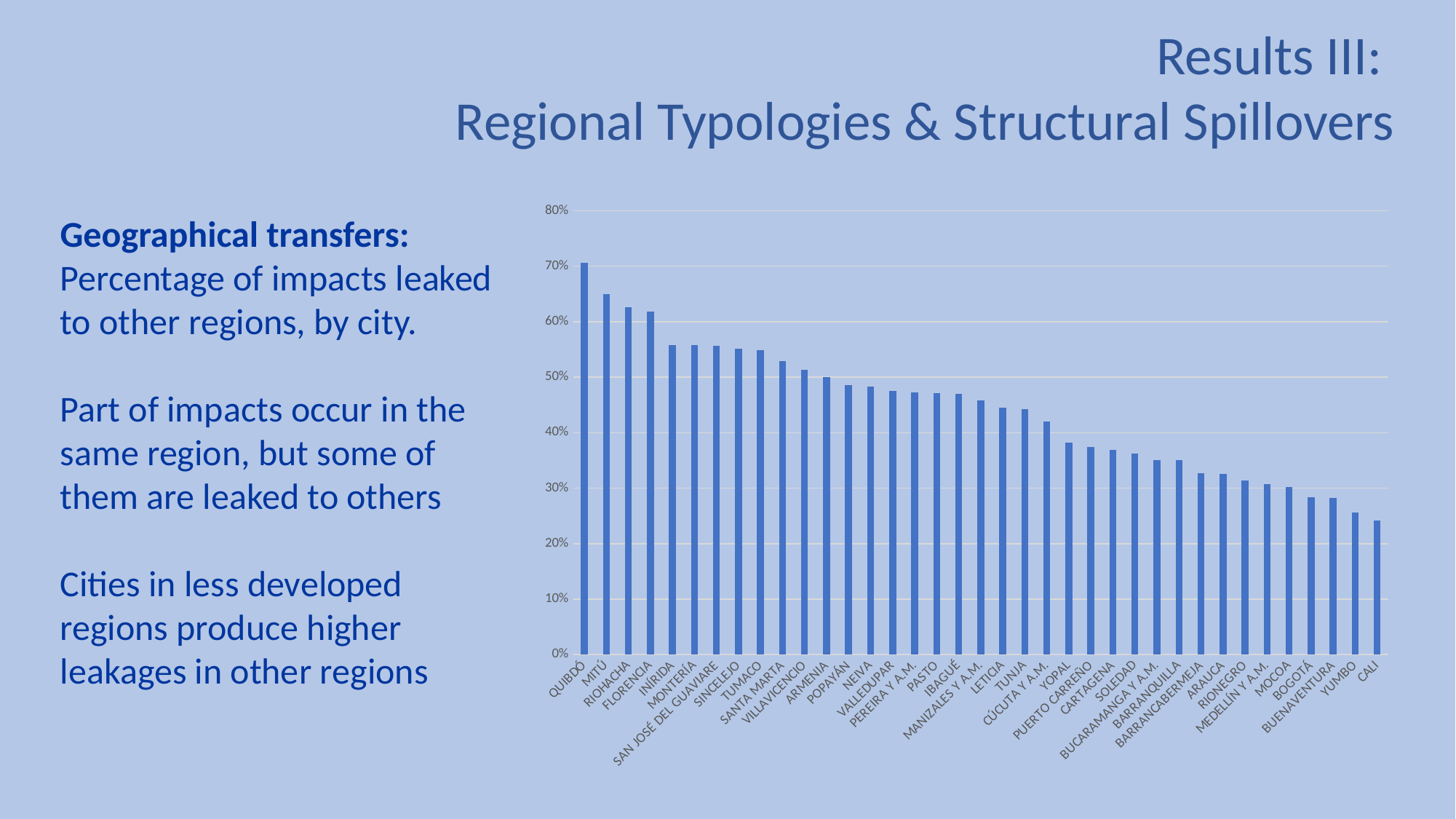
What kind of chart is shown on the slide? bar chart Which city has the highest percentage of impacts leaked to other regions? QUIBDÓ Is the value for CALI greater or less than 30%? less Is the value for SANTA MARTA greater or less than 50%? greater Which has a larger value, MITÚ or BOGOTÁ? MITÚ Which has a larger value, TUNJA or FLORENCIA? FLORENCIA How many cities are plotted in the chart? 37 What is the highest value shown on the vertical axis of the chart? 80% Do the values rise or fall moving from left to right along the x axis? fall Which city has the lowest percentage of impacts leaked to other regions? CALI Is the value for QUIBDÓ greater or less than 60%? greater